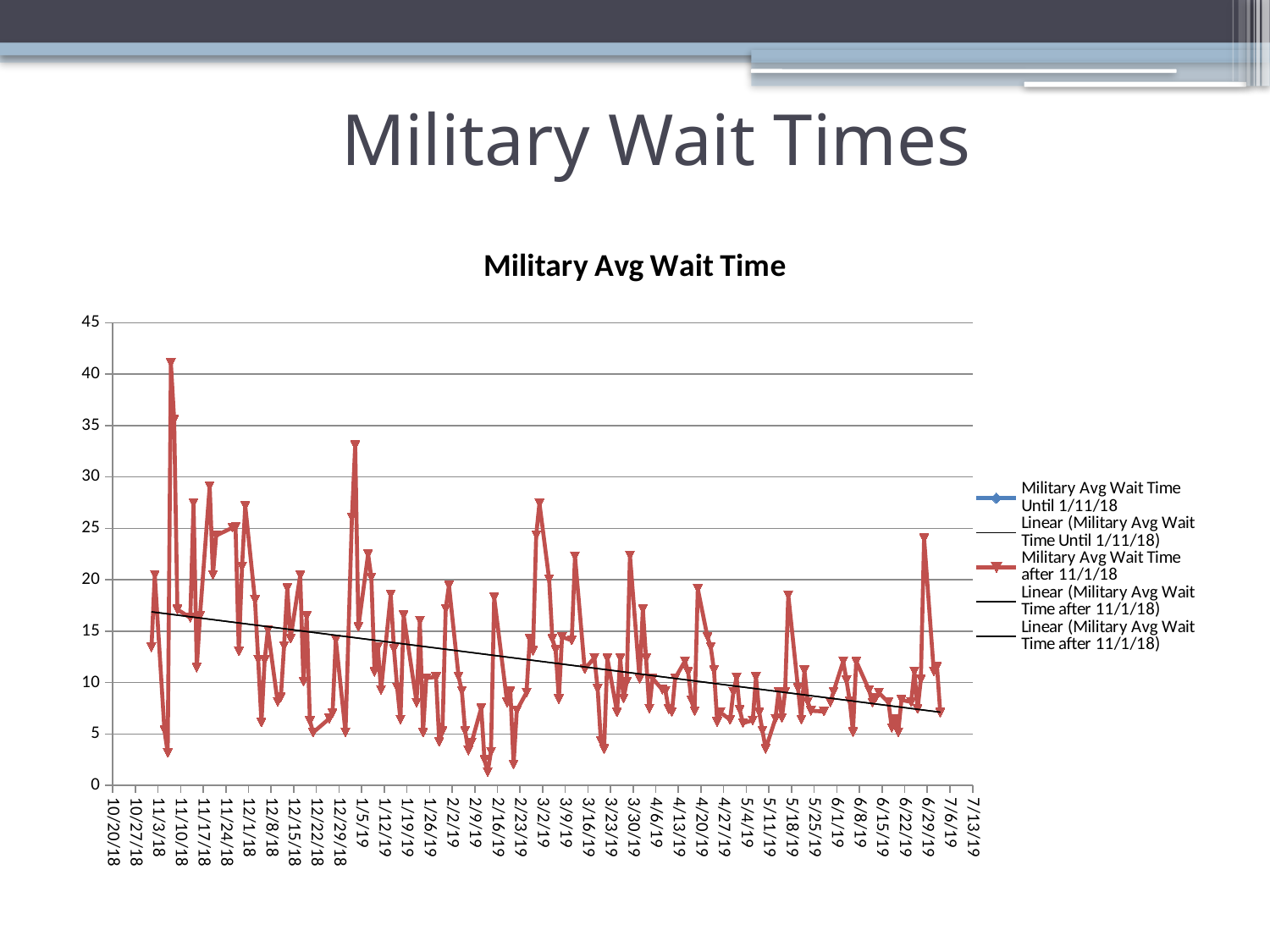
Is the lowest value plotted on the chart greater or less than 5? less Is the spike in wait time near 1/5/19 greater or less than 30? greater Is the highest value plotted on the chart greater or less than 40? greater What is the highest value shown on the vertical axis? 45 What is the title of the chart? Military Avg Wait Time How many entries does the chart's legend list? 5 Does the linear trend line for Military Avg Wait Time after 11/1/18 rise or fall from left to right? fall What kind of chart is shown on the slide? line chart